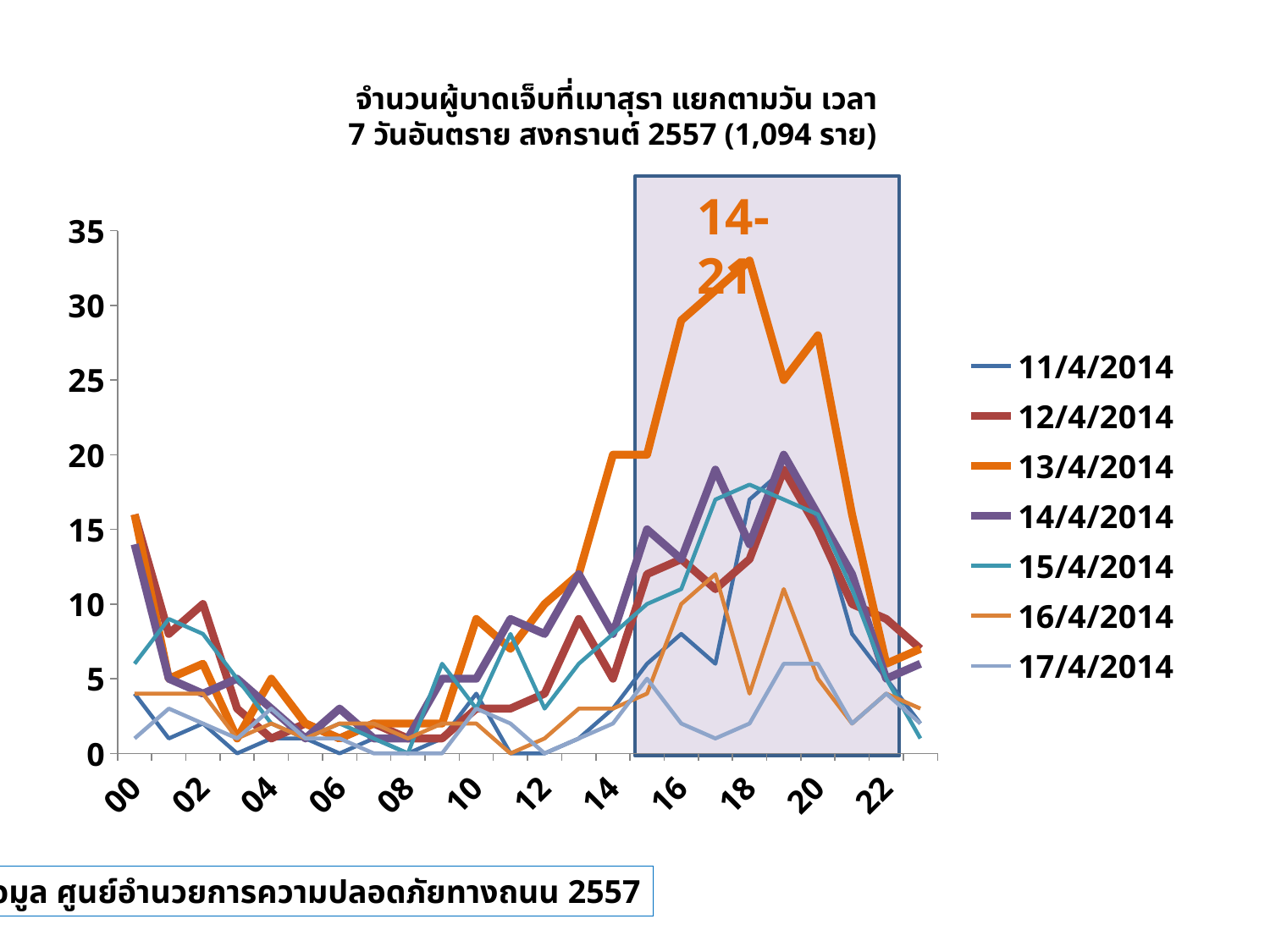
Is the value for 17/4/2014 at hour 19 greater or less than 10? less Does the 13/4/2014 series rise or fall between hour 12 and hour 18? rise Is the value for 13/4/2014 at hour 18 greater or less than 30? greater Which series reaches the highest value on the chart? 13/4/2014 Is the value for 15/4/2014 at hour 18 greater or less than 15? greater At hour 18, which series has the larger value, 13/4/2014 or 14/4/2014? 13/4/2014 How many series does the legend list? 7 How many hour labels are shown on the x axis? 12 What kind of chart is shown on the slide? line chart What is the highest tick value shown on the y axis? 35